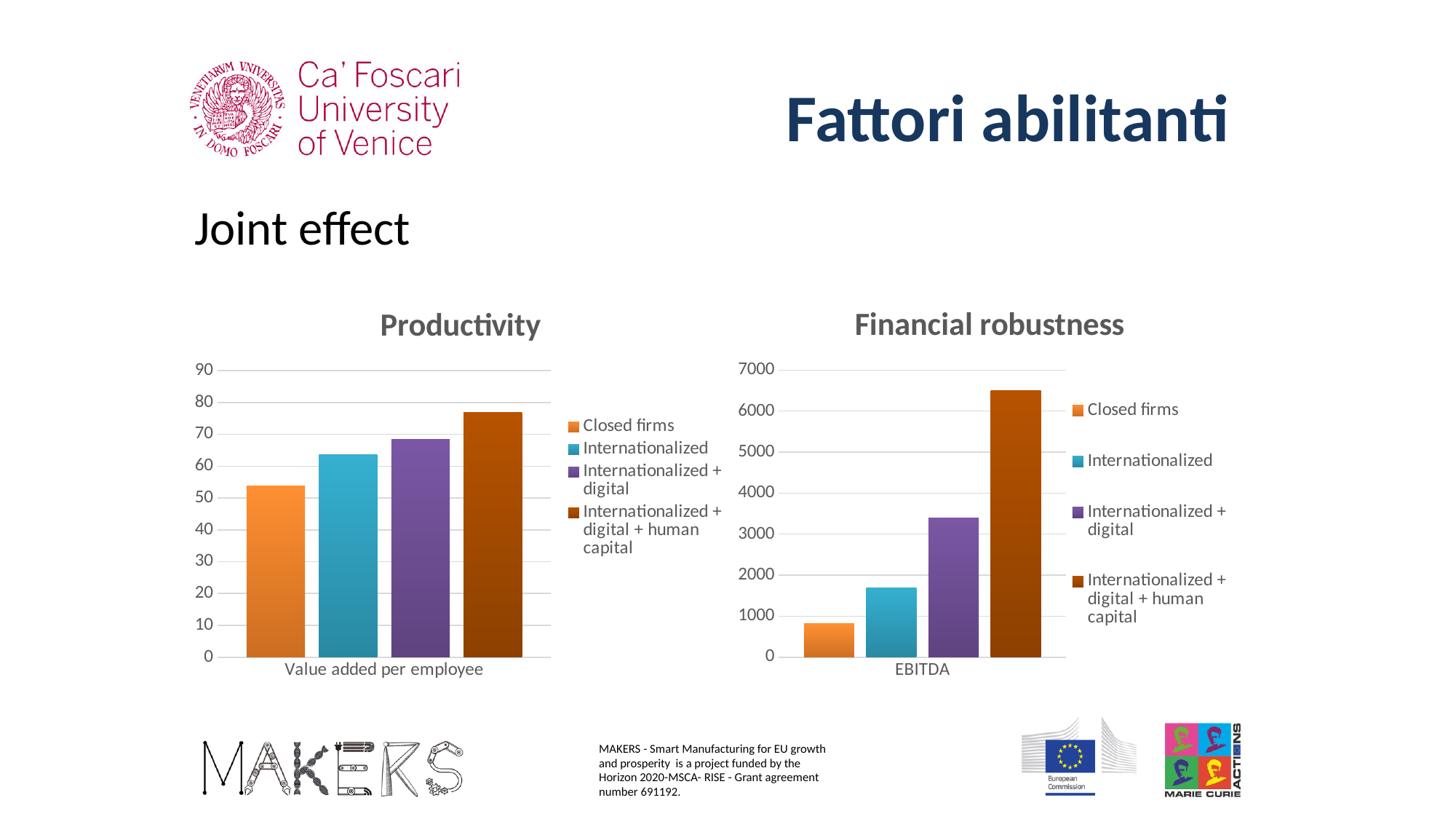
In the Productivity chart, which series has the highest value? Internationalized + digital + human capital In the Financial robustness chart, which series has the lowest EBITDA? Closed firms In the Financial robustness chart, is the value for Closed firms greater or less than 1000? less How many series does the legend of the Financial robustness chart list? 4 In the Financial robustness chart, which series has the highest EBITDA? Internationalized + digital + human capital What kind of chart is the Productivity chart? bar chart In the Productivity chart, is the value for Closed firms greater or less than 60? less In the Financial robustness chart, is the value for Internationalized + digital greater or less than 3000? greater What is the category label on the x axis of the Productivity chart? Value added per employee In the Financial robustness chart, which is larger: Internationalized or Internationalized + digital? Internationalized + digital In the Productivity chart, which series has the lowest value? Closed firms